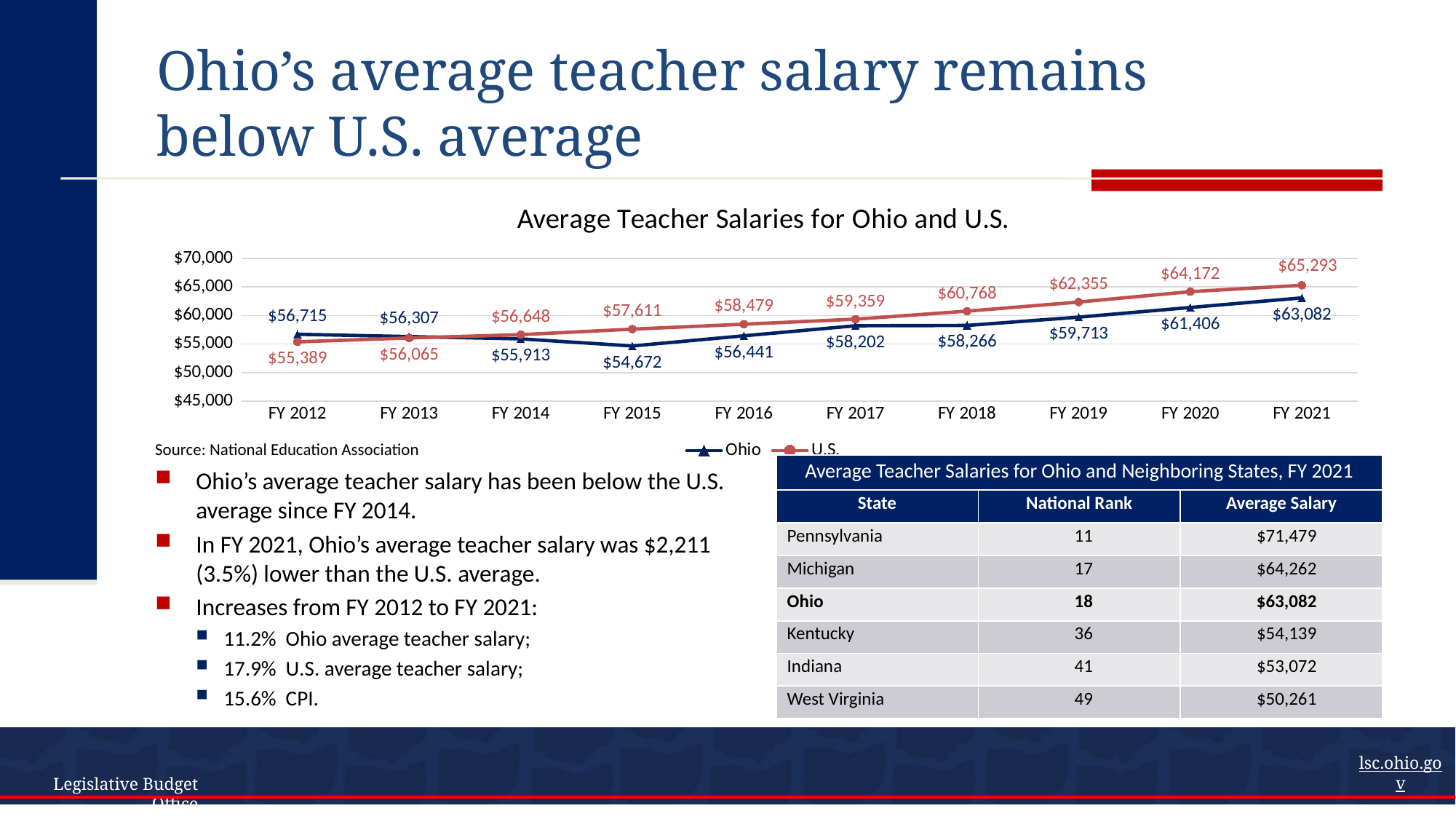
What type of chart is used to show average teacher salaries for Ohio and the U.S.? Line chart How many series does the chart's legend list? 2 What is the difference between the Ohio and U.S. average teacher salaries in FY 2012 on the chart? $1,326 What was the U.S. average teacher salary in FY 2018 according to the chart? $60,768 In FY 2012, which was higher on the chart: Ohio's average teacher salary or the U.S. average? Ohio How many fiscal years are plotted on the chart? 10 In which fiscal year was Ohio's average teacher salary lowest on the chart? FY 2015 What is the difference between the U.S. and Ohio average teacher salaries in FY 2021 on the chart? $2,211 What was the U.S. average teacher salary in FY 2012 according to the chart? $55,389 What was Ohio's average teacher salary in FY 2015 according to the chart? $54,672 In which fiscal year was the U.S. average teacher salary highest on the chart? FY 2021 Does the U.S. average teacher salary rise or fall from FY 2012 to FY 2021 on the chart? Rise